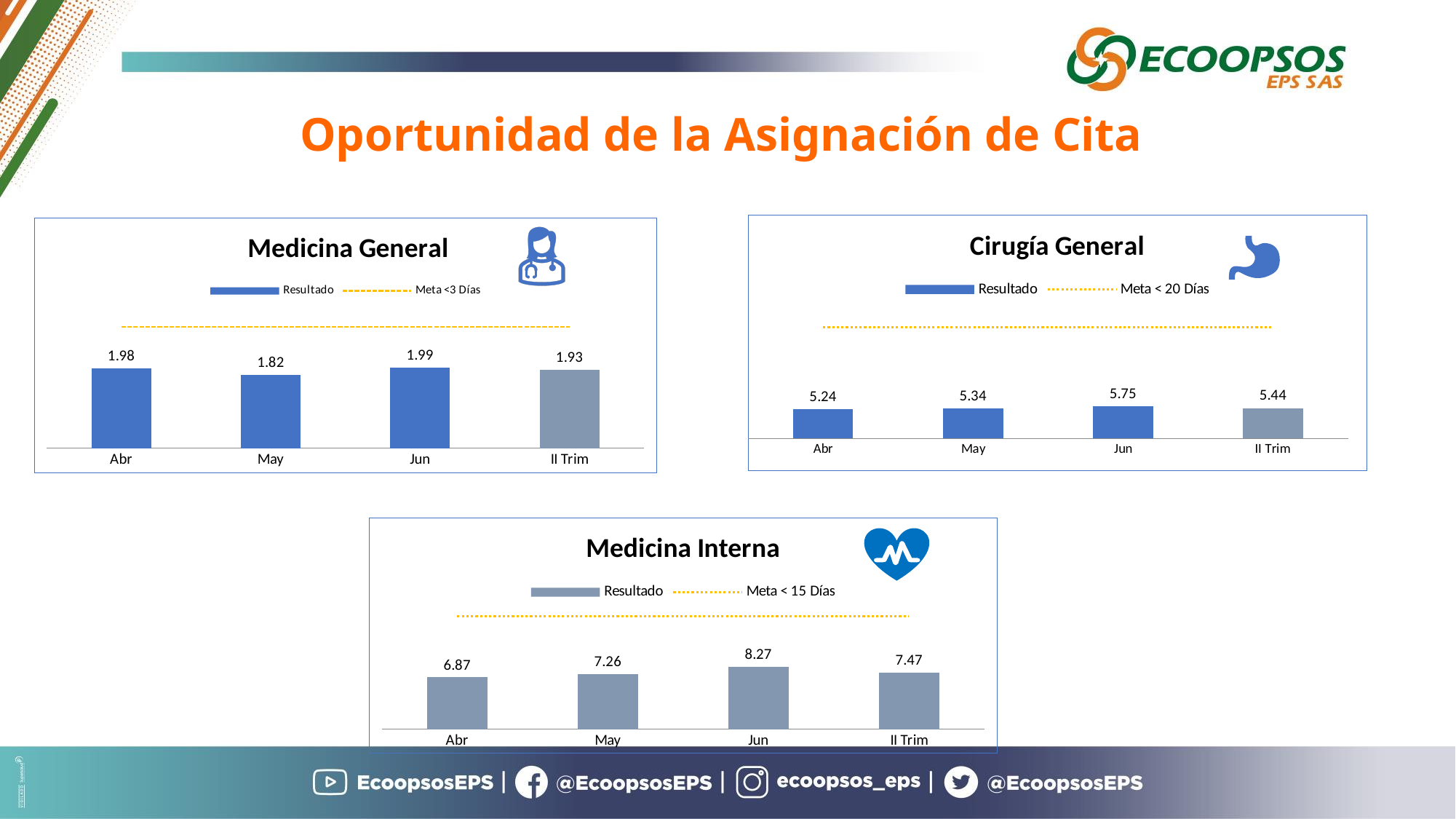
In the Medicina Interna chart, how many categories are shown on the x axis? 4 What type of chart is the Cirugía General chart? Combination bar and line chart How many entries does the legend of the Medicina General chart list? 2 In the Medicina General chart, which month has the highest Resultado value? Jun In the Medicina Interna chart, what is the value for Jun? 8.27 In the Cirugía General chart, what is the value for II Trim? 5.44 In the Cirugía General chart, which month has the lowest value? Abr In the Cirugía General chart, what is the target (Meta) shown in the legend? Meta < 20 Días In the Medicina General chart, what is the Resultado value for May? 1.82 In the Medicina Interna chart, which is larger, the value for Abr or the value for May? May In the Medicina Interna chart, what is the difference between the Jun and Abr values? 1.40 In the Medicina General chart, what is the difference between the Jun and May values? 0.17